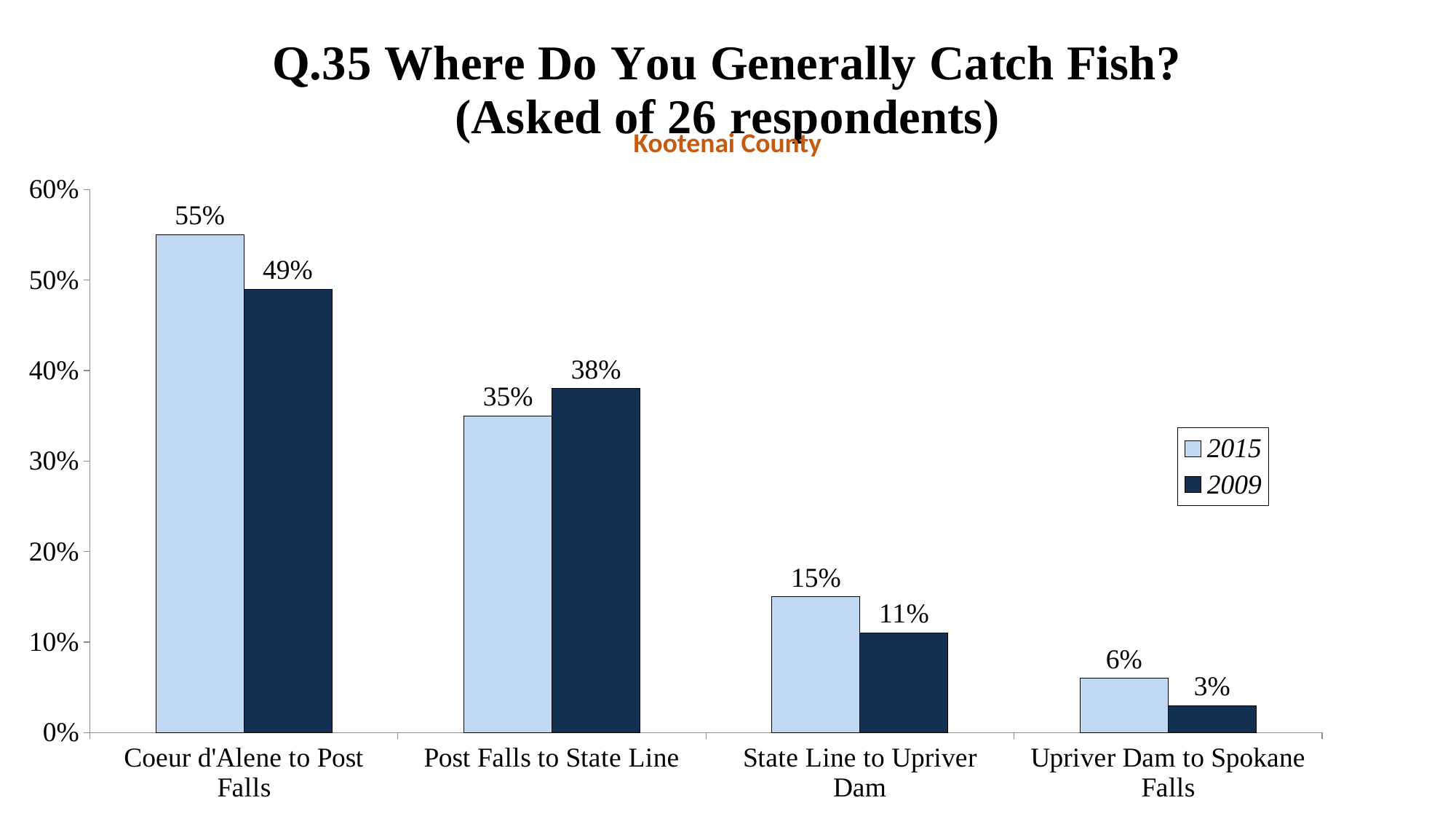
How many series does the legend list? 2 For Post Falls to State Line, which is larger: the 2015 value or the 2009 value? 2009 Which category has the lowest 2009 value? Upriver Dam to Spokane Falls What is the 2015 value for Coeur d'Alene to Post Falls? 55% Do the 2015 values rise or fall from left to right along the x axis? Fall What is the 2009 value for Upriver Dam to Spokane Falls? 3% Which category has the highest 2015 value? Coeur d'Alene to Post Falls What is the difference between the 2015 and 2009 values for State Line to Upriver Dam? 4% What is the 2009 value for Post Falls to State Line? 38% How many categories are shown on the x axis? 4 Is the 2009 value for Coeur d'Alene to Post Falls greater or less than 40%? greater What kind of chart is shown on the slide? Bar chart